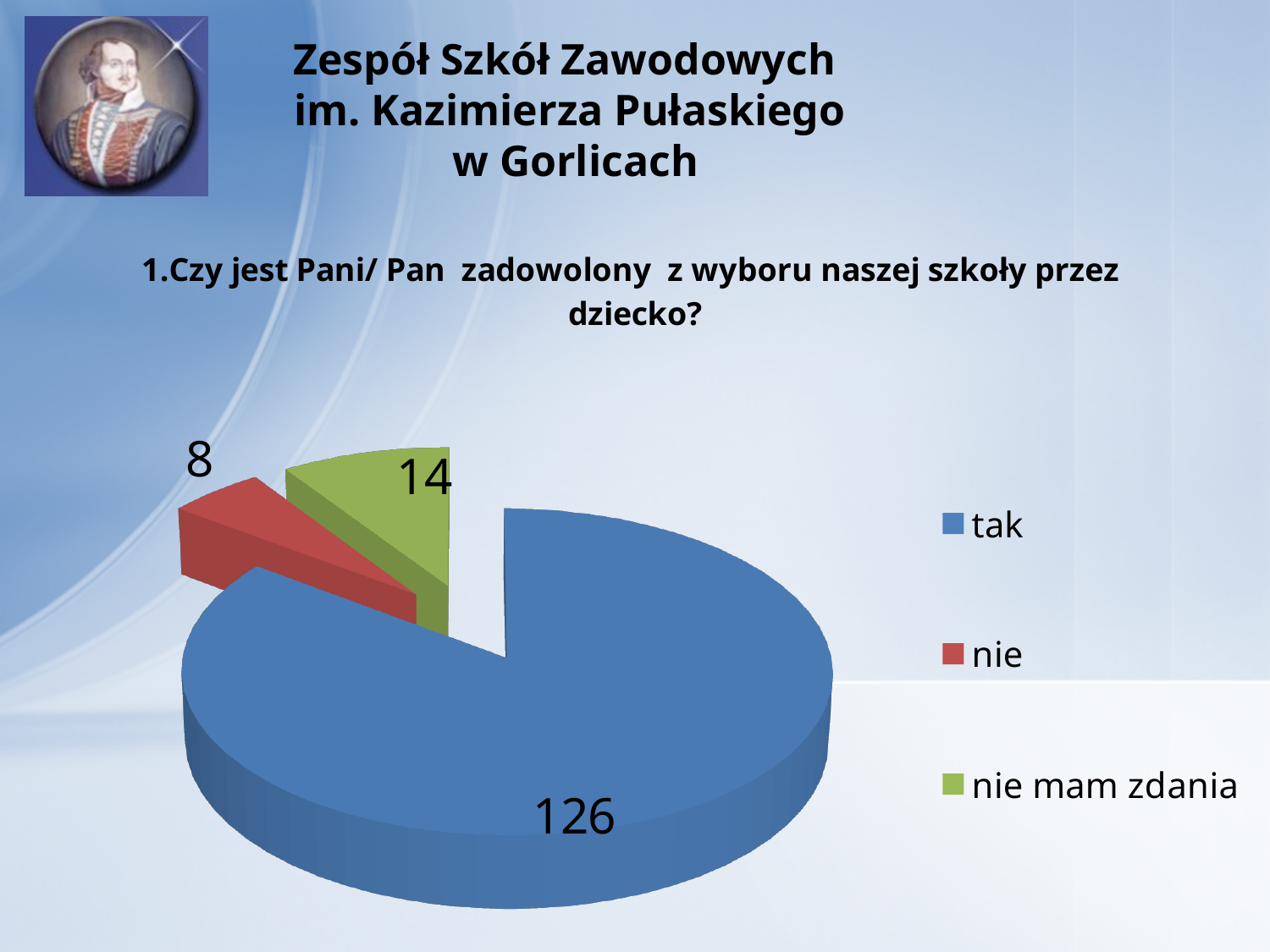
How many categories does the pie chart show? 3 Which is larger, the value for "nie" or the value for "nie mam zdania"? nie mam zdania What value is shown for the "tak" slice? 126 Which category has the smallest slice of the pie? nie What colour is the "nie" slice in the pie chart? red What kind of chart is shown on the slide? pie chart What value is shown for the "nie mam zdania" slice? 14 What value is shown for the "nie" slice? 8 What is the difference between the values for "nie mam zdania" and "nie"? 6 Which category has the largest slice of the pie? tak What is the difference between the values for "tak" and "nie mam zdania"? 112 What is the total of all the values shown in the pie chart? 148